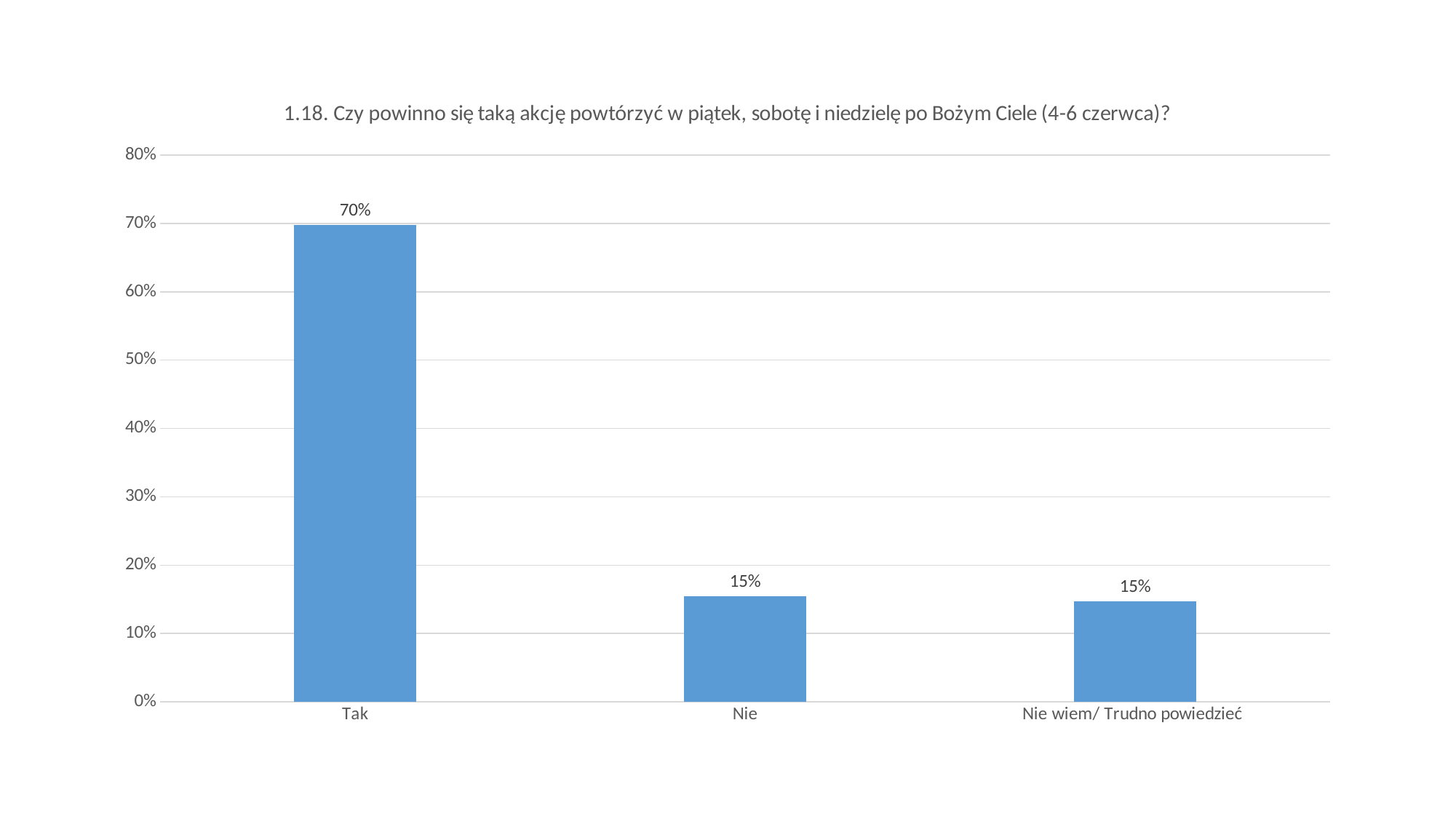
What is the value for Nie wiem/ Trudno powiedzieć? 15% Is the value for Nie greater or less than 20%? less What colour are the bars in the chart? blue What is the highest value shown on the y axis? 80% What kind of chart is shown on the slide? bar chart How many categories are shown on the x axis? 3 Is the value for Tak greater or less than 60%? greater What is the difference between the values for Tak and Nie? 55% What is the value for Nie? 15% What is the value for Tak? 70% Which category has the highest value? Tak Which is larger, the value for Tak or the value for Nie wiem/ Trudno powiedzieć? Tak